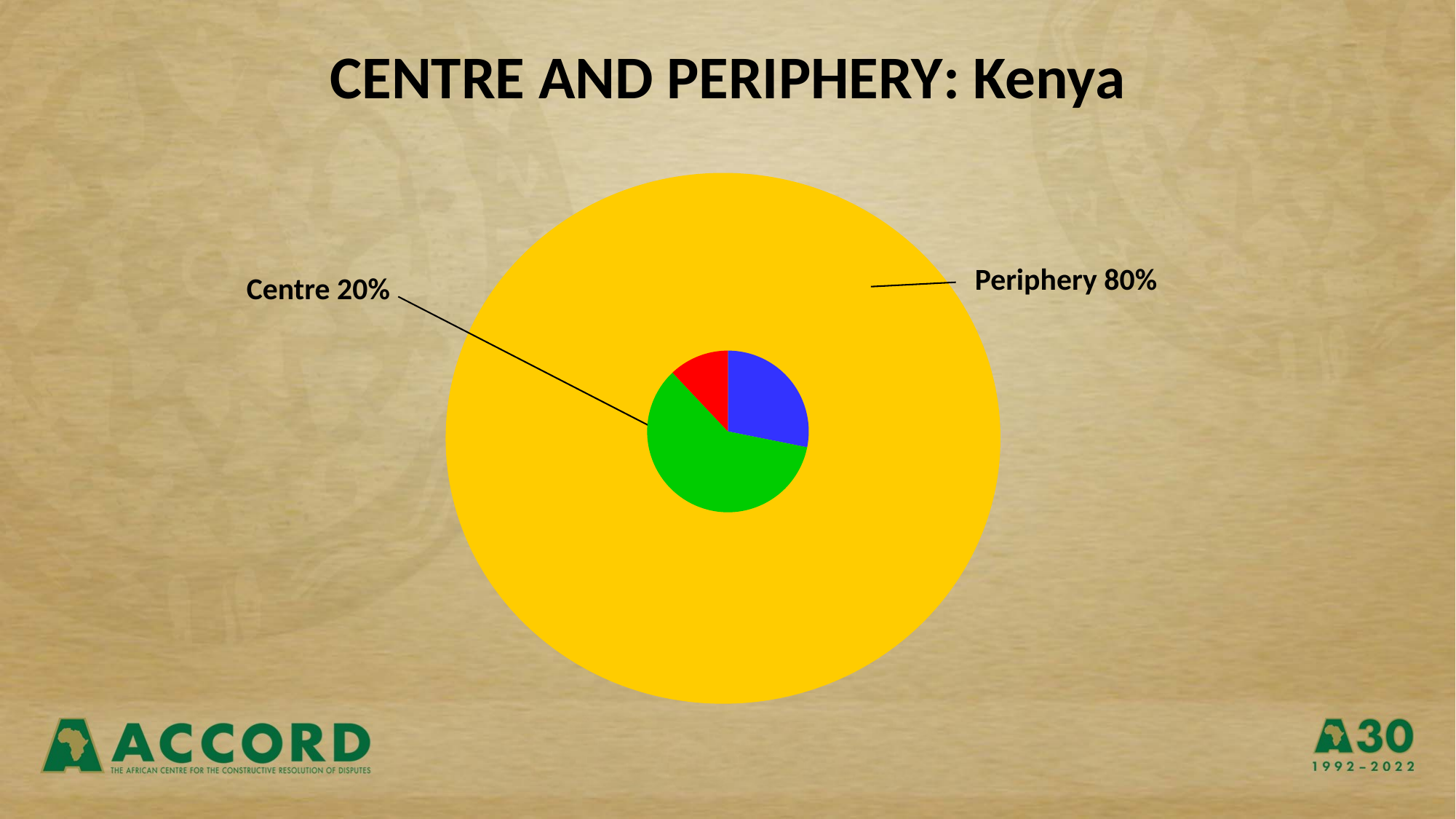
How many labelled segments does the diagram show? 2 Which colour slice is the largest within the small inner Centre circle? Green How many slices make up the small inner circle representing the Centre? 3 What is the title of the slide? CENTRE AND PERIPHERY: Kenya What colour represents the Periphery? Yellow Which labelled segment has the largest share? Periphery What is the difference in percentage points between the Periphery and the Centre? 60 percentage points Which colour slice is the smallest within the small inner Centre circle? Red Which is larger, the Centre or the Periphery? Periphery What percentage is shown for the Centre? 20% Which labelled segment has the smallest share? Centre What percentage is shown for the Periphery? 80%